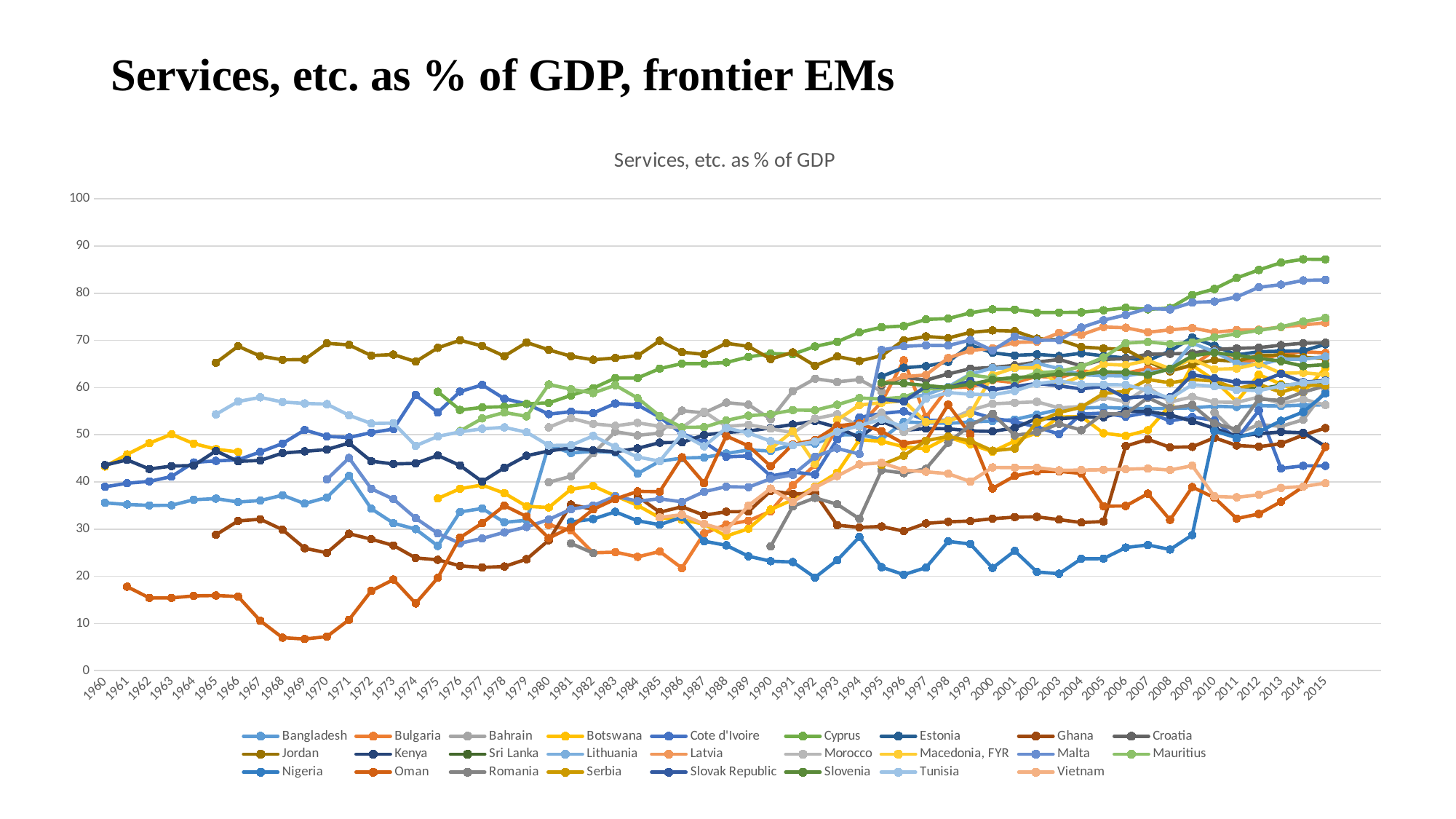
Does the topmost line in the chart generally rise or fall from 1990 to 2015? rise How many series does the legend list? 26 Which series has the lowest value in 1968? Oman What is the first year shown on the x axis? 1960 What is the last year shown on the x axis? 2015 Is the value for Oman in 1969 greater or less than 10? less Is the value for Jordan in 1965 greater or less than 60? greater Which series has the highest value in 1970? Jordan What kind of chart is shown on the slide? line chart What is the title printed above the plot area of the chart? Services, etc. as % of GDP What is the highest value shown on the y axis? 100 How many years are plotted along the x axis? 56